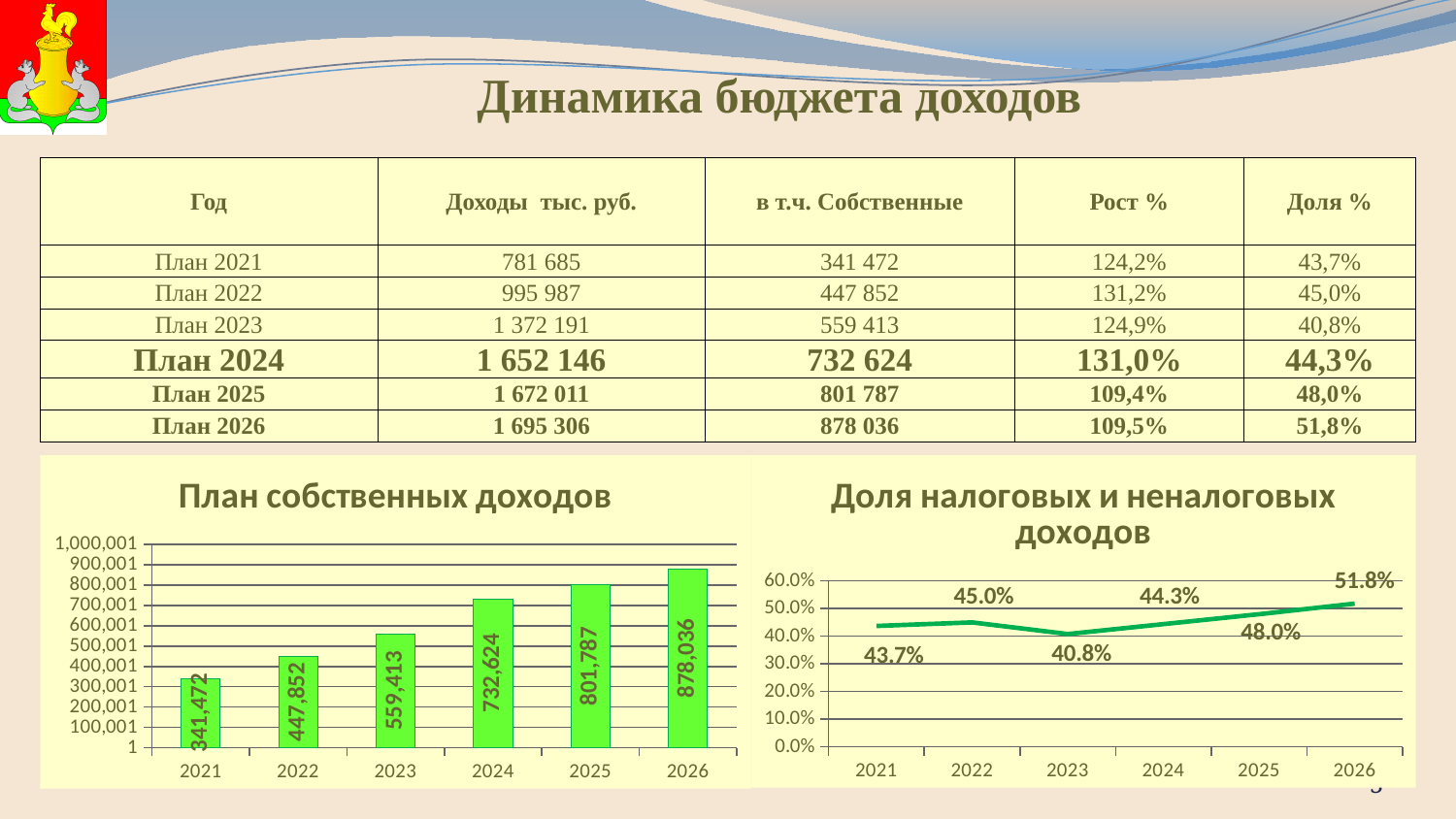
In the chart titled "План собственных доходов", what is the value for 2021? 341,472 What kind of chart is the one titled "План собственных доходов"? bar chart In the chart titled "План собственных доходов", what is the difference between the values for 2026 and 2025? 76,249 What kind of chart is the one titled "Доля налоговых и неналоговых доходов"? line chart In the chart titled "Доля налоговых и неналоговых доходов", what is the value for 2023? 40.8% In the chart titled "Доля налоговых и неналоговых доходов", which is larger, the value for 2022 or the value for 2024? 2022 In the chart titled "План собственных доходов", do the values rise or fall from 2021 to 2026? rise In the chart titled "План собственных доходов", which year has the lowest value? 2021 In the chart titled "Доля налоговых и неналоговых доходов", which year has the highest value? 2026 In the chart titled "План собственных доходов", how many bars are plotted? 6 In the chart titled "План собственных доходов", what is the value for 2024? 732,624 In the chart titled "План собственных доходов", which year has the highest value? 2026